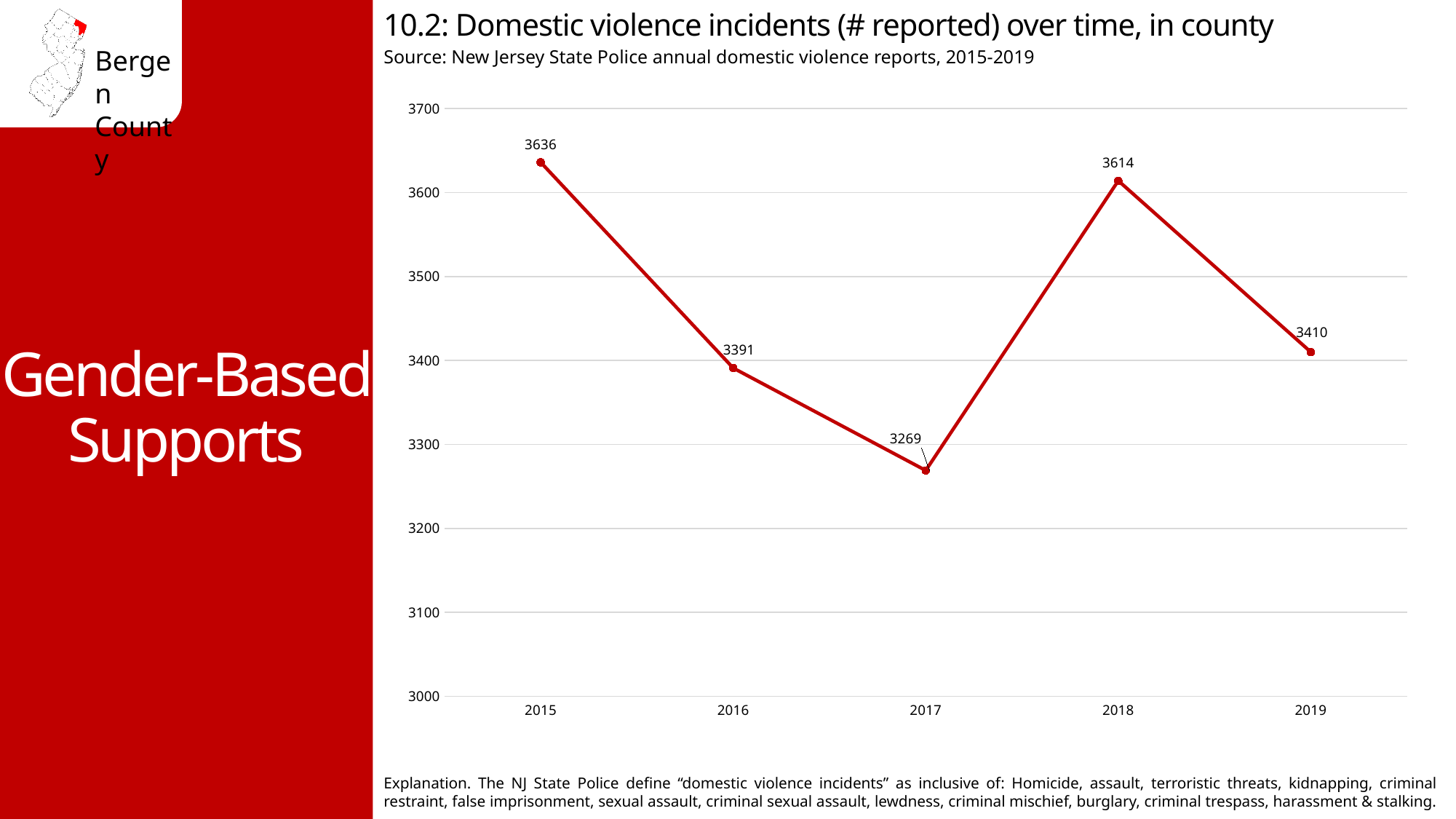
What type of chart is shown on the slide? line chart Which year had more reported incidents, 2016 or 2019? 2019 How many years are plotted on the chart? 5 What is the difference in reported incidents between 2015 and 2016? 245 What is the difference in reported incidents between 2018 and 2017? 345 Did the number of reported incidents rise or fall from 2018 to 2019? fall Which year had the highest number of reported domestic violence incidents? 2015 Is the value for 2018 greater or less than 3500? greater How many domestic violence incidents were reported in 2019? 3410 Which year had the lowest number of reported domestic violence incidents? 2017 How many domestic violence incidents were reported in 2015? 3636 How many domestic violence incidents were reported in 2017? 3269